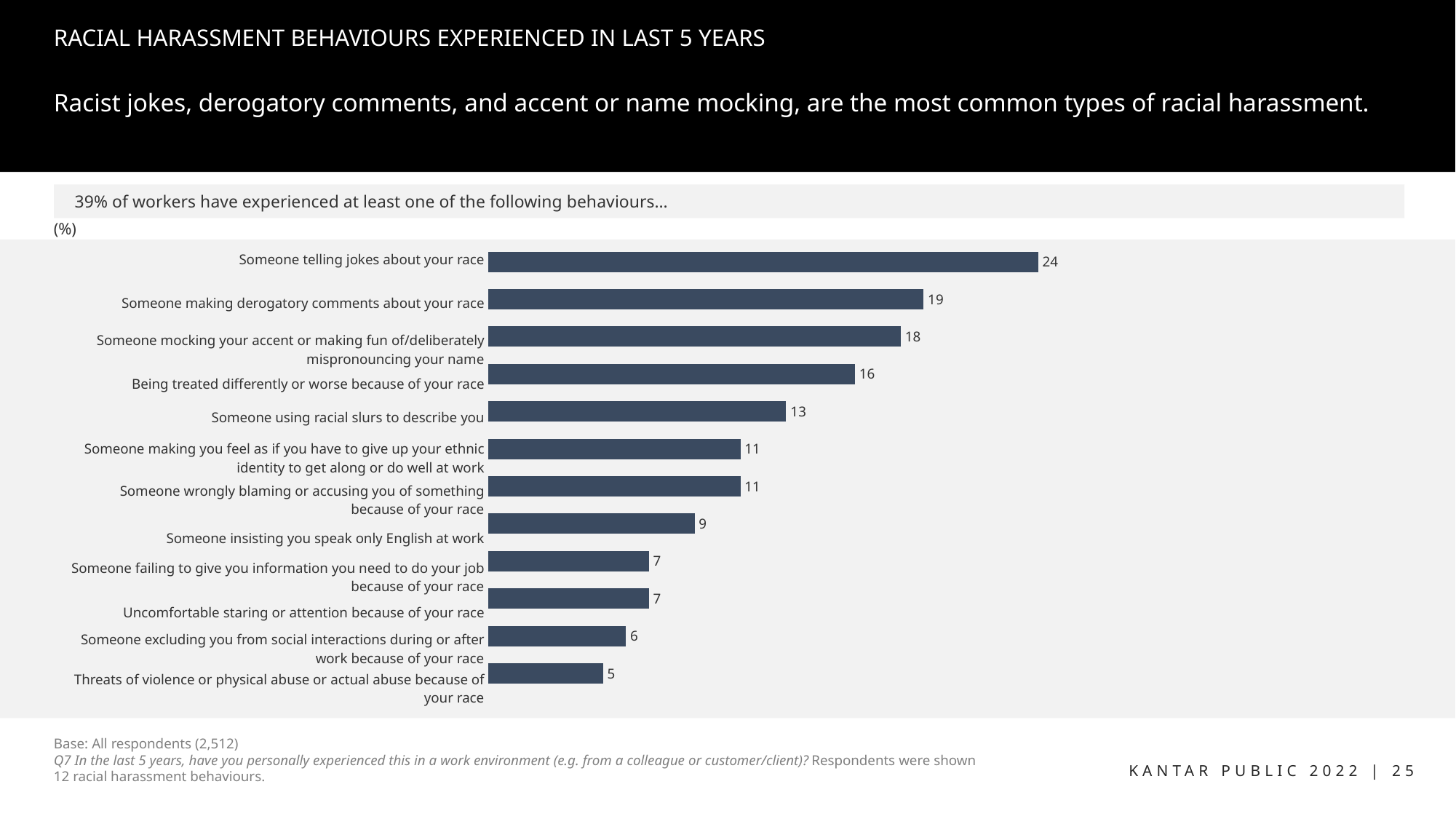
What is the difference between the values for 'Someone telling jokes about your race' and 'Someone making derogatory comments about your race'? 5 Which behaviour has the lowest value in the chart? Threats of violence or physical abuse or actual abuse because of your race How many behaviours (bars) are shown in the chart? 12 Which behaviour has the highest value in the chart? Someone telling jokes about your race What type of chart is shown on the slide? Bar chart Which is larger: the value for 'Being treated differently or worse because of your race' or the value for 'Someone using racial slurs to describe you'? Being treated differently or worse because of your race What is the value for 'Someone using racial slurs to describe you'? 13 What is the value for 'Someone insisting you speak only English at work'? 9 According to the text above the chart, what percentage of workers have experienced at least one of the listed behaviours? 39% What percentage of workers experienced someone telling jokes about their race? 24 What is the difference between the values for 'Someone mocking your accent or making fun of/deliberately mispronouncing your name' and 'Threats of violence or physical abuse or actual abuse because of your race'? 13 What is the value for 'Someone excluding you from social interactions during or after work because of your race'? 6